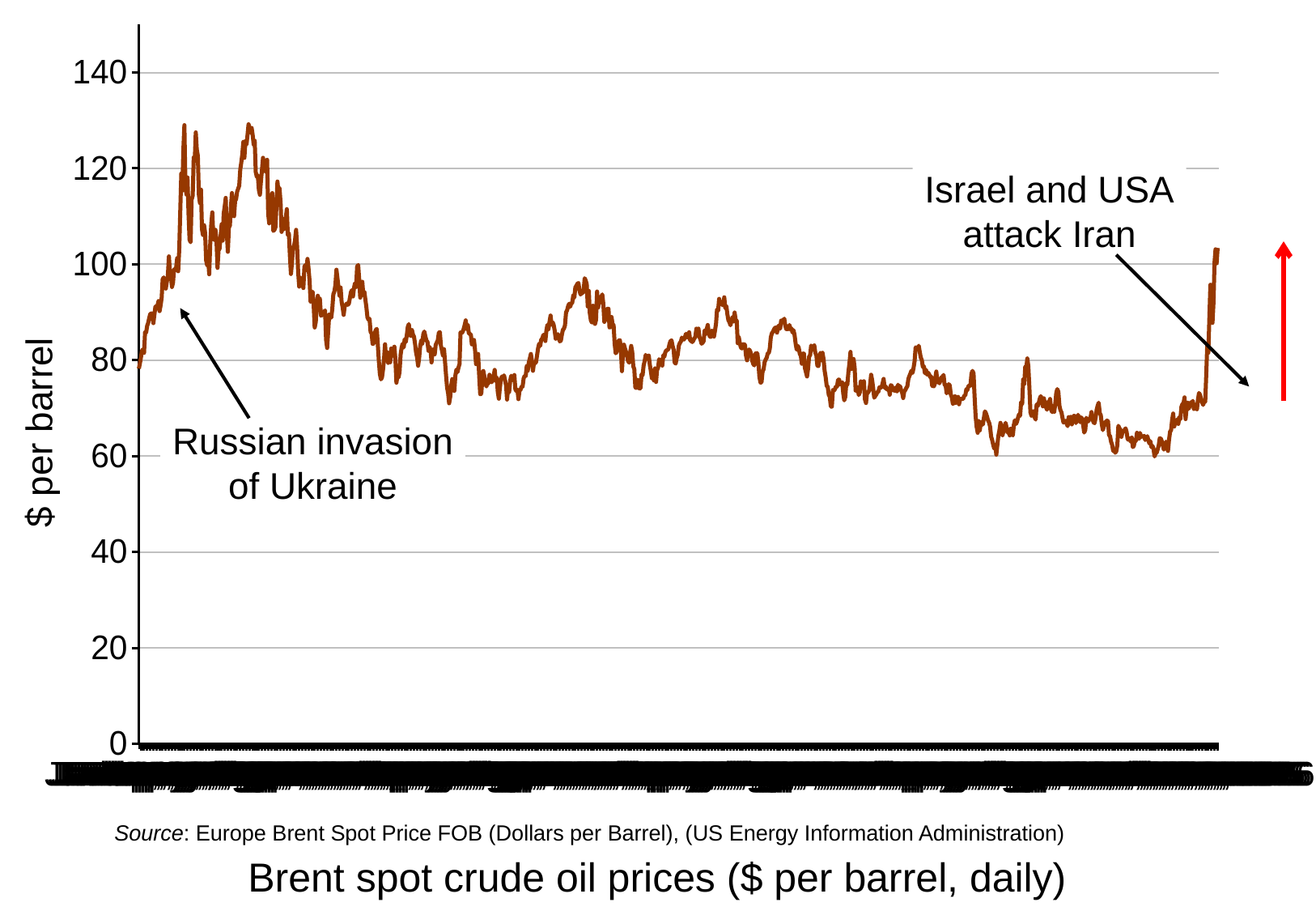
What kind of chart is shown on the slide? line chart Is the price at the point marked 'Russian invasion of Ukraine' greater or less than 80? greater Is the highest price reached on the chart greater or less than 120? greater Does the price rise or fall at the far right end of the chart, after the point marked 'Israel and USA attack Iran'? rise Does the price rise or fall from its peak near the left of the chart to the low point near the right? fall What is the label on the vertical axis of the chart? $ per barrel What is the title of the chart? Brent spot crude oil prices ($ per barrel, daily) Is the price at the point marked 'Israel and USA attack Iran' greater or less than 80? less How many data series are plotted on the chart? 1